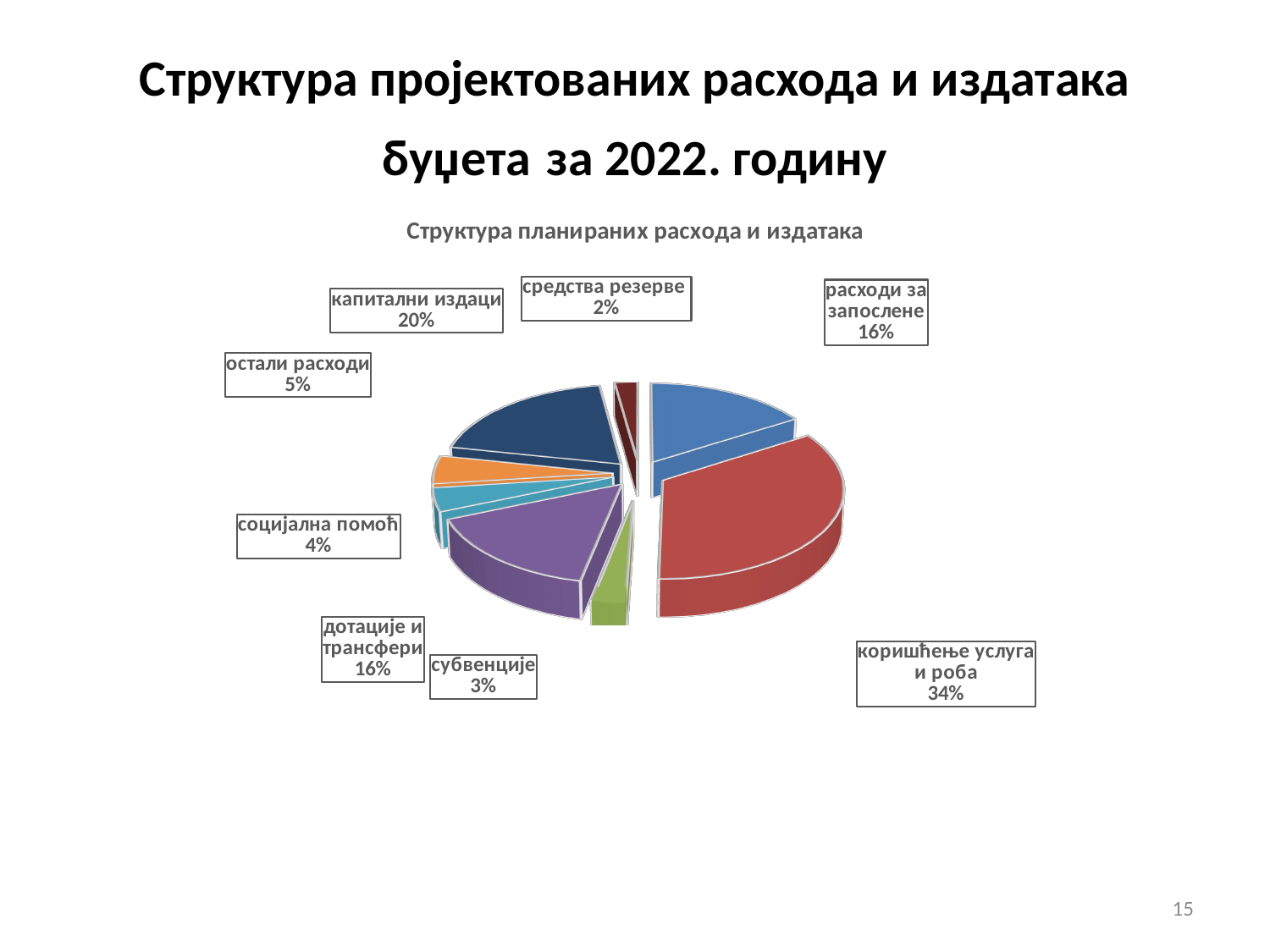
How many categories (slices) does the pie chart have? 8 What is the value shown for "дотације и трансфери"? 16% What is the value shown for "социјална помоћ"? 4% What is the value shown for "капитални издаци"? 20% Which category has the smallest share of the pie? средства резерве What share of the pie does "коришћење услуга и роба" represent? 34% What is the difference in percentage points between "коришћење услуга и роба" and "капитални издаци"? 14 Which is larger, the share for "остали расходи" or the share for "субвенције"? остали расходи What type of chart is shown on the slide? pie chart Which category has the largest share of the pie? коришћење услуга и роба What is the title of the chart? Структура планираних расхода и издатака What is the value shown for "средства резерве"? 2%